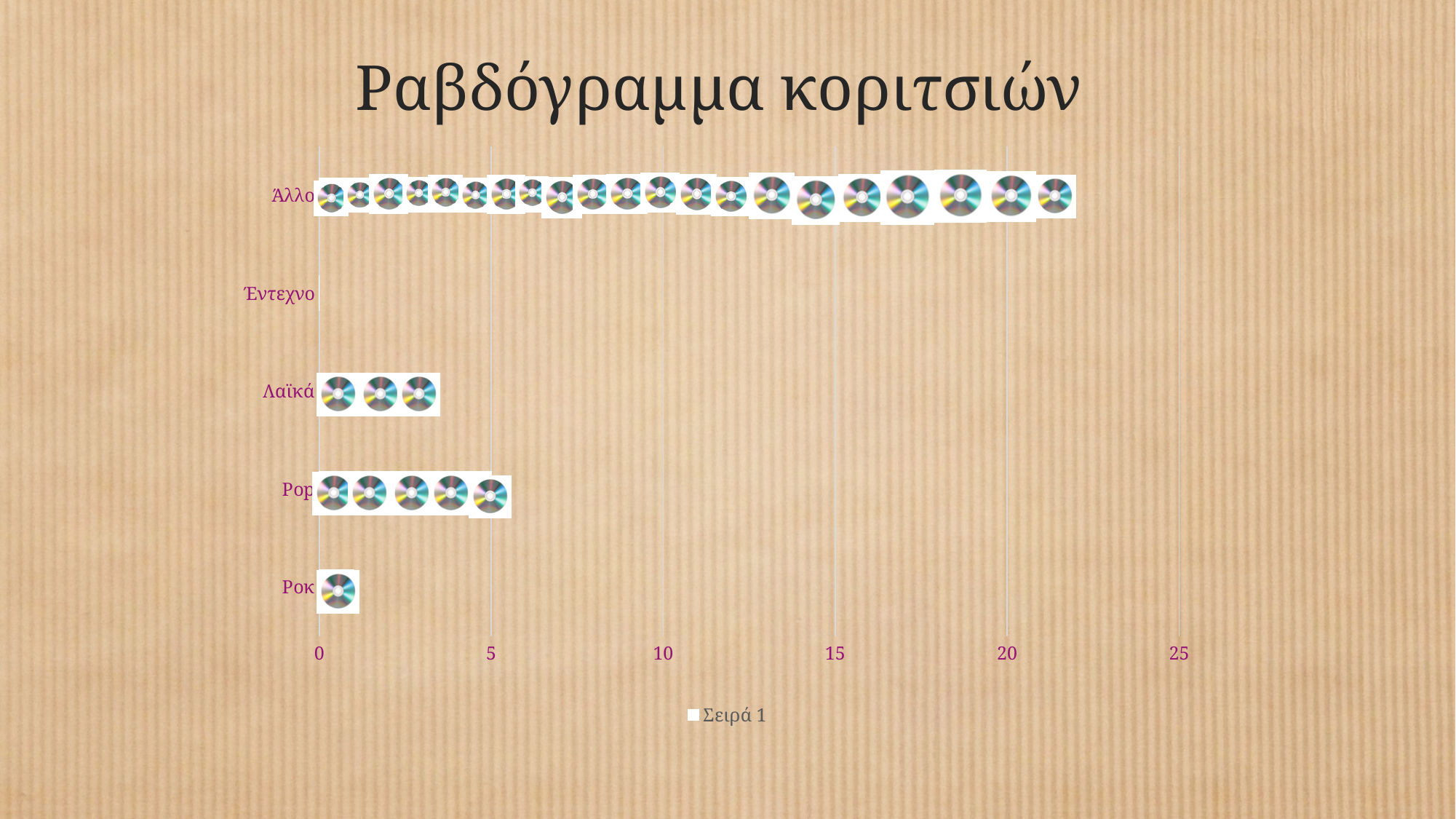
Which category has the highest value? Άλλο Is the value for Λαϊκά greater or less than 5? less Is the value for Άλλο greater or less than 20? greater Which has a larger value, Pop or Λαϊκά? Pop Which category has the lowest value? Έντεχνο How many series does the legend list? 1 What is the title of the chart? Ραβδόγραμμα κοριτσιών Is the value for Άλλο greater or less than 25? less Which has a larger value, Ροκ or Άλλο? Άλλο How many categories are shown on the chart? 5 What is the name of the series shown in the legend? Σειρά 1 What type of chart is shown on the slide? Bar chart